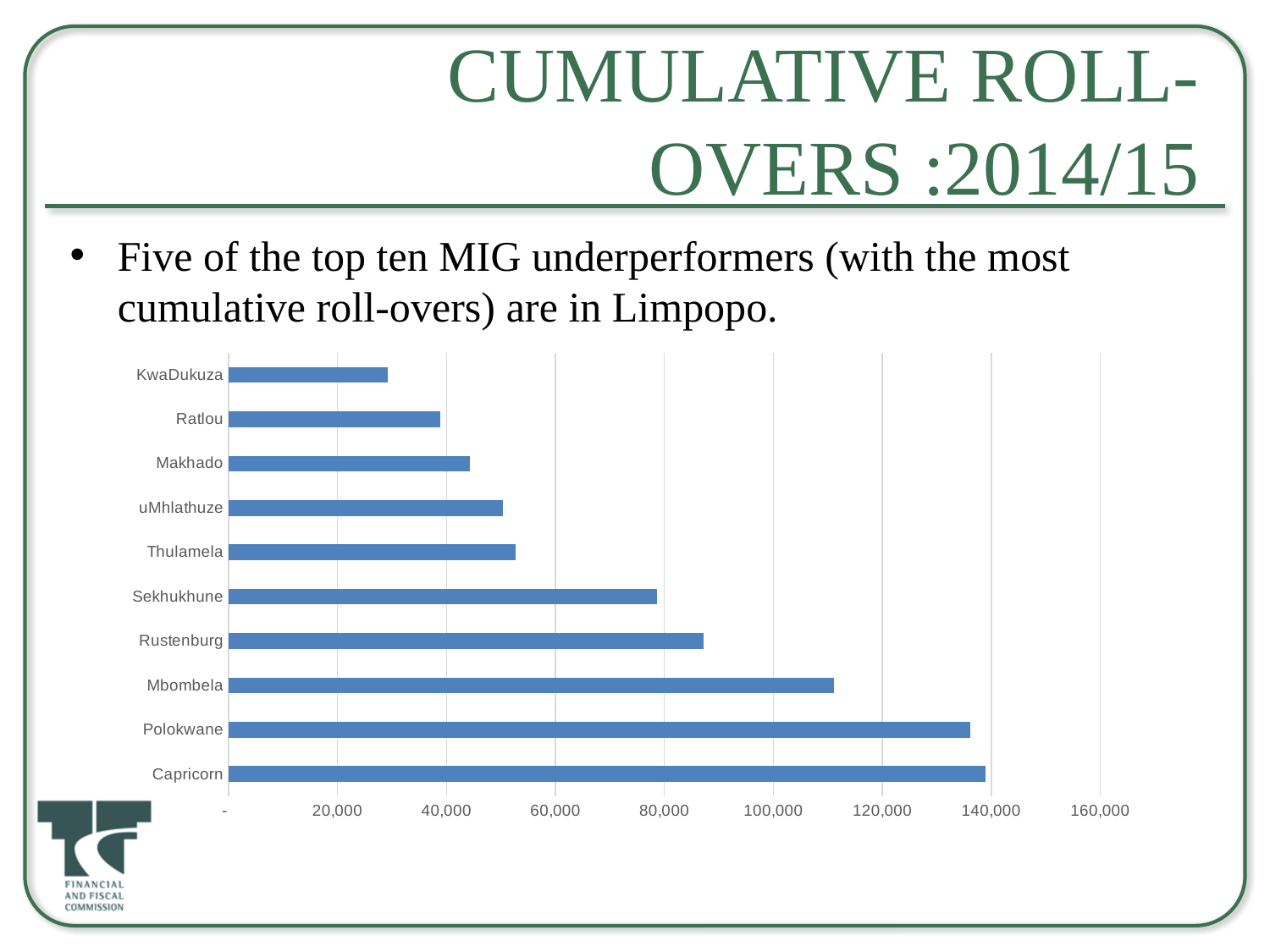
Is the value for KwaDukuza greater or less than 20,000? greater Is the value for Capricorn greater or less than 120,000? greater Which municipality has the lowest cumulative roll-over in the chart? KwaDukuza Which has the larger value, Sekhukhune or Thulamela? Sekhukhune How many municipalities are shown in the chart? 10 Is the value for Mbombela greater or less than 100,000? greater Which has the larger value, Mbombela or Rustenburg? Mbombela What kind of chart is shown on the slide? bar chart What is the highest value labelled on the horizontal axis of the chart? 160,000